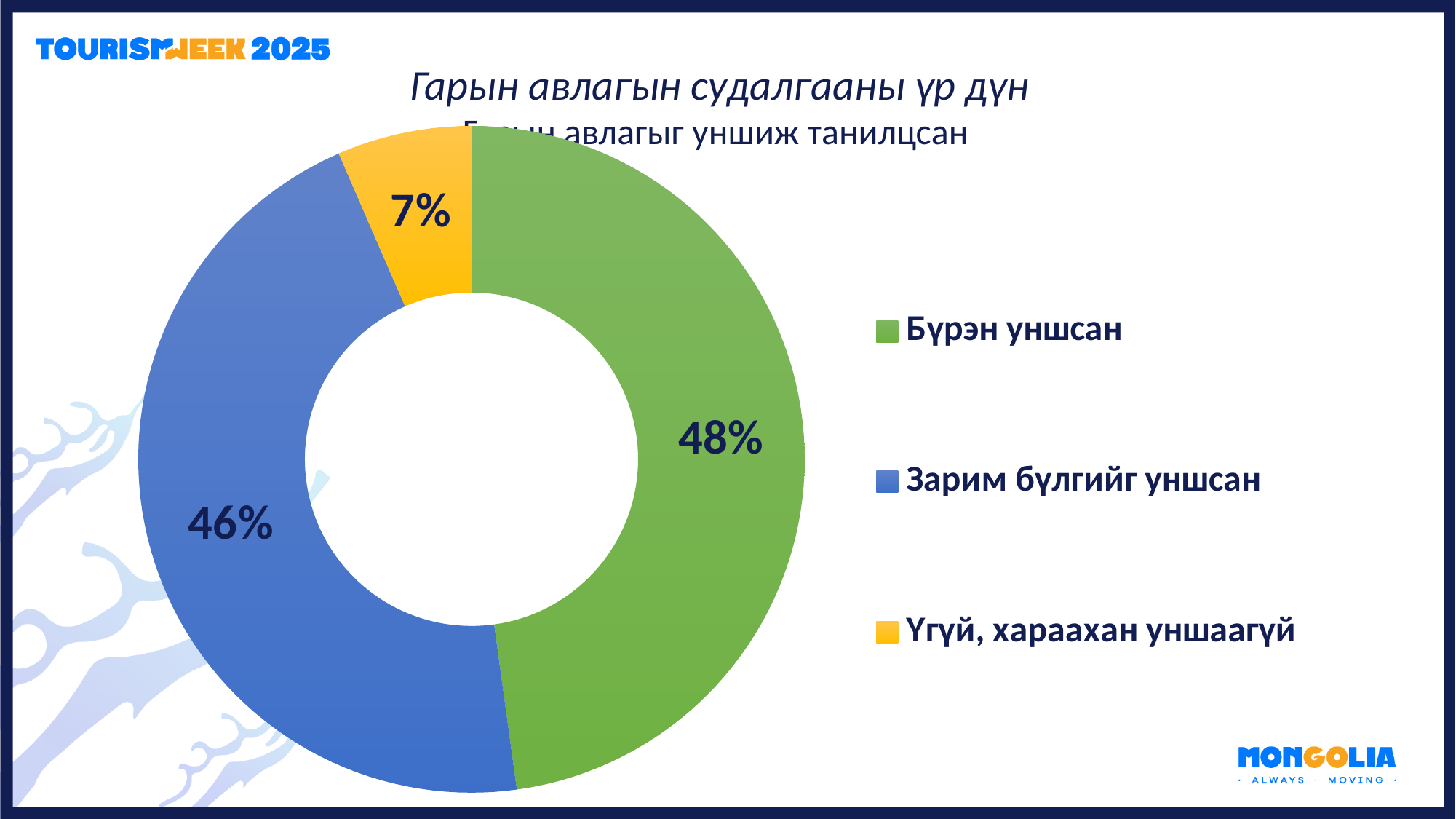
What percentage is shown for "Бүрэн уншсан"? 48% How many categories does the chart show? 3 What type of chart is shown on the slide? Pie chart (donut) Which category has the largest share of the chart? Бүрэн уншсан What is the difference in percentage points between "Бүрэн уншсан" and "Зарим бүлгийг уншсан"? 2 What colour represents "Үгүй, хараахан уншаагүй" in the chart? Yellow What is the difference in percentage points between "Зарим бүлгийг уншсан" and "Үгүй, хараахан уншаагүй"? 39 What is the title of the slide above the chart? Гарын авлагын судалгааны үр дүн What percentage is shown for "Үгүй, хараахан уншаагүй"? 7% Which category has the smallest share of the chart? Үгүй, хараахан уншаагүй What percentage is shown for "Зарим бүлгийг уншсан"? 46% Which is larger: the share for "Зарим бүлгийг уншсан" or the share for "Үгүй, хараахан уншаагүй"? Зарим бүлгийг уншсан